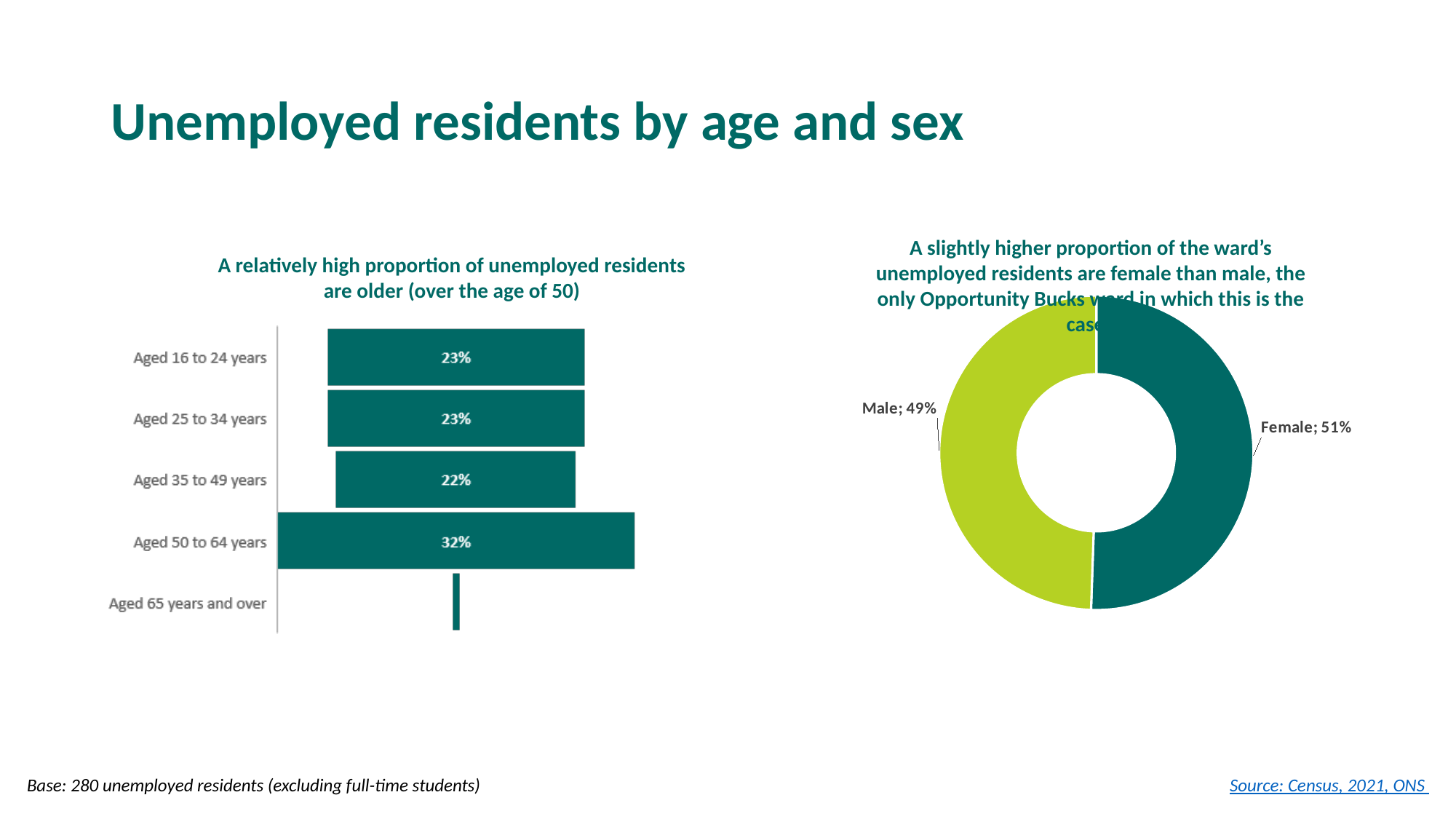
In the right-hand doughnut chart, what share of unemployed residents are male? 49% In the left bar chart, what is the difference between the values for Aged 50 to 64 years and Aged 35 to 49 years? 10 percentage points In the right-hand doughnut chart, which is larger: the Female share or the Male share? Female In the left bar chart, which age group has the highest proportion of unemployed residents? Aged 50 to 64 years In the left bar chart, which age group has the lowest proportion of unemployed residents? Aged 65 years and over How many age groups are shown in the left bar chart? 5 In the left bar chart, which is larger: the value for Aged 25 to 34 years or Aged 35 to 49 years? Aged 25 to 34 years In the left bar chart, what is the value for Aged 16 to 24 years? 23% In the right-hand doughnut chart, what share of unemployed residents are female? 51% In the left bar chart, what percentage of unemployed residents are aged 50 to 64 years? 32% What type of chart is the chart on the left of the slide? Bar chart In the left bar chart, what is the value for Aged 35 to 49 years? 22%